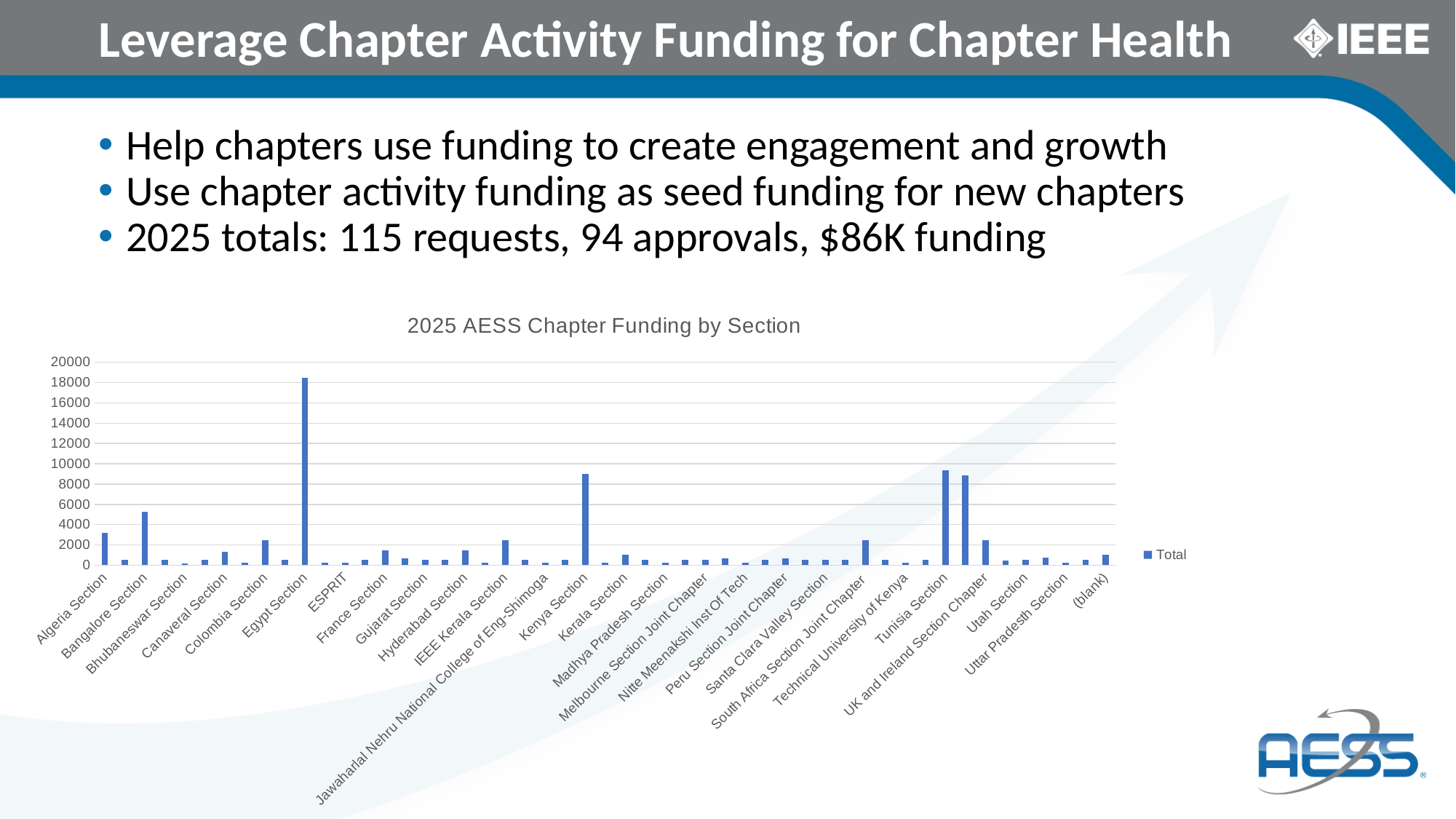
Which has the larger value, Bangalore Section or Algeria Section? Bangalore Section What is the name of the series shown in the chart's legend? Total What kind of chart is shown on the slide? bar chart How many series does the chart's legend list? 1 Is the value for Bangalore Section greater or less than 4000? greater Is the value for Utah Section greater or less than 2000? less Is the value for Egypt Section greater or less than 16000? greater Which section has the highest funding in the chart? Egypt Section Which has the larger value, Egypt Section or Bangalore Section? Egypt Section What is the title of the chart on the slide? 2025 AESS Chapter Funding by Section